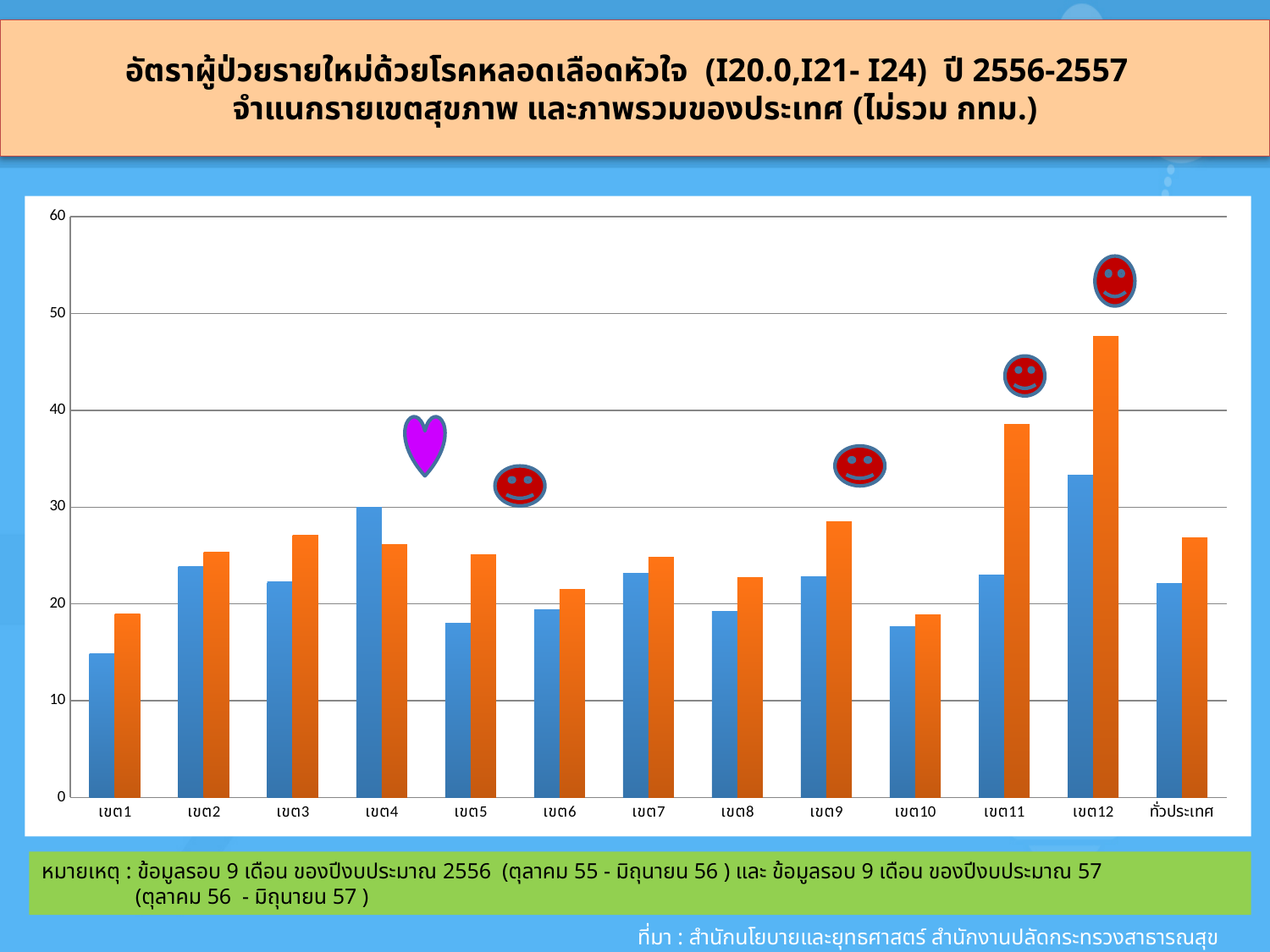
Is the orange bar for เขต12 greater or less than 40? greater Is the blue bar for เขต12 greater or less than 30? greater For เขต4, which bar is taller, the blue bar or the orange bar? the blue bar Which is taller, the orange bar for เขต11 or the orange bar for เขต12? เขต12 What kind of chart is shown on the slide? bar chart Above which category is the purple heart symbol placed? เขต4 Which category has the tallest blue bar? เขต12 Is the blue bar for เขต1 greater or less than 20? less How many categories are shown along the x axis of the chart? 13 Which category has the shortest blue bar? เขต1 Which category has the tallest orange bar? เขต12